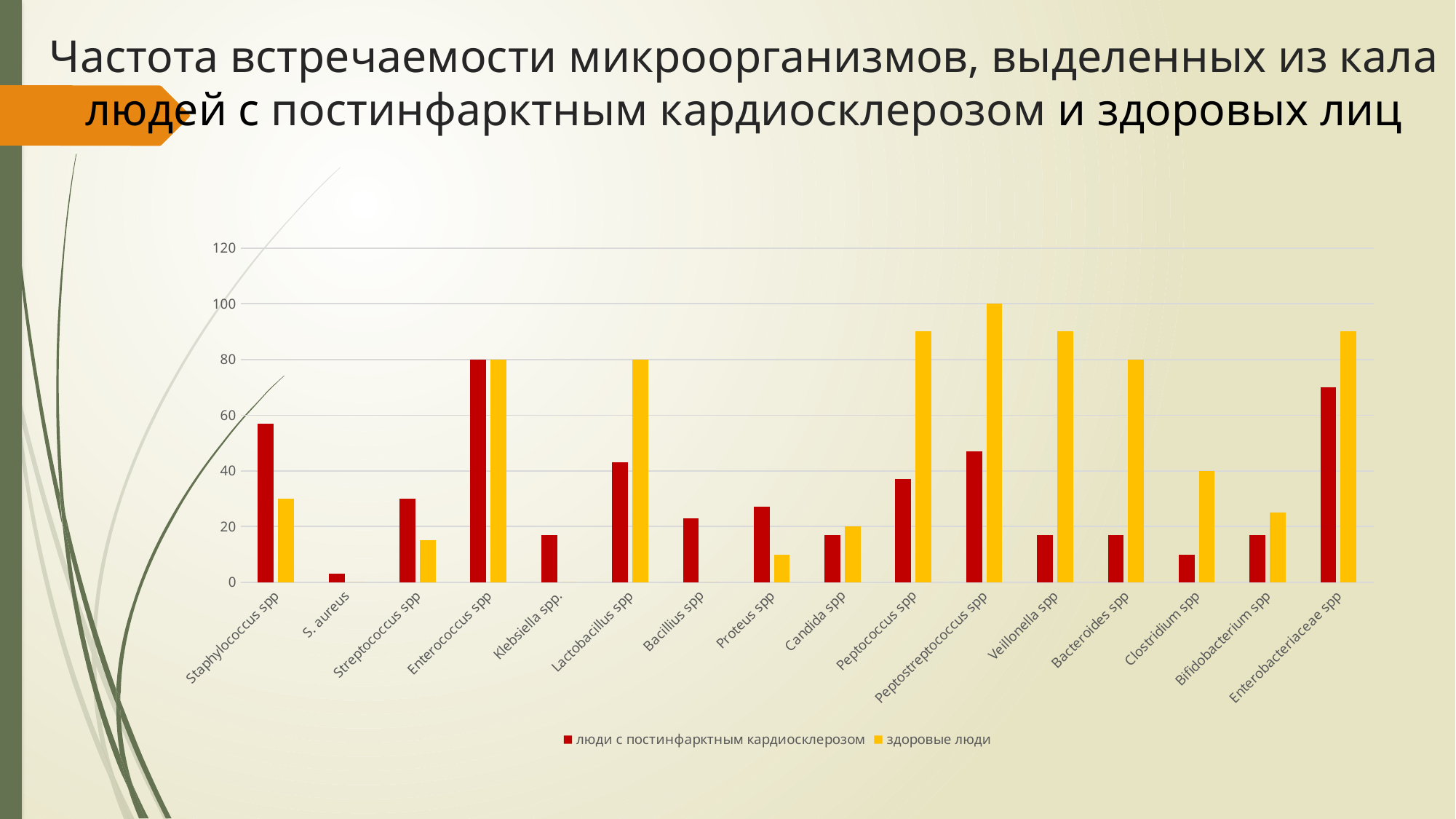
What is the difference between the здоровые люди values for Peptostreptococcus spp and Clostridium spp? 60 What kind of chart is shown on the slide? bar chart What is the value for здоровые люди for Peptostreptococcus spp? 100 Which category has the highest value for здоровые люди? Peptostreptococcus spp Which category has the highest value for люди с постинфарктным кардиосклерозом? Enterococcus spp How many series does the legend list? 2 What is the value for здоровые люди for Bacteroides spp? 80 What is the value for здоровые люди for Clostridium spp? 40 What is the value for люди с постинфарктным кардиосклерозом for Enterococcus spp? 80 Is the value for люди с постинфарктным кардиосклерозом for Staphylococcus spp greater or less than 40? greater How many microorganism categories are shown on the x axis? 16 For Lactobacillus spp, which series has the larger value: люди с постинфарктным кардиосклерозом or здоровые люди? здоровые люди